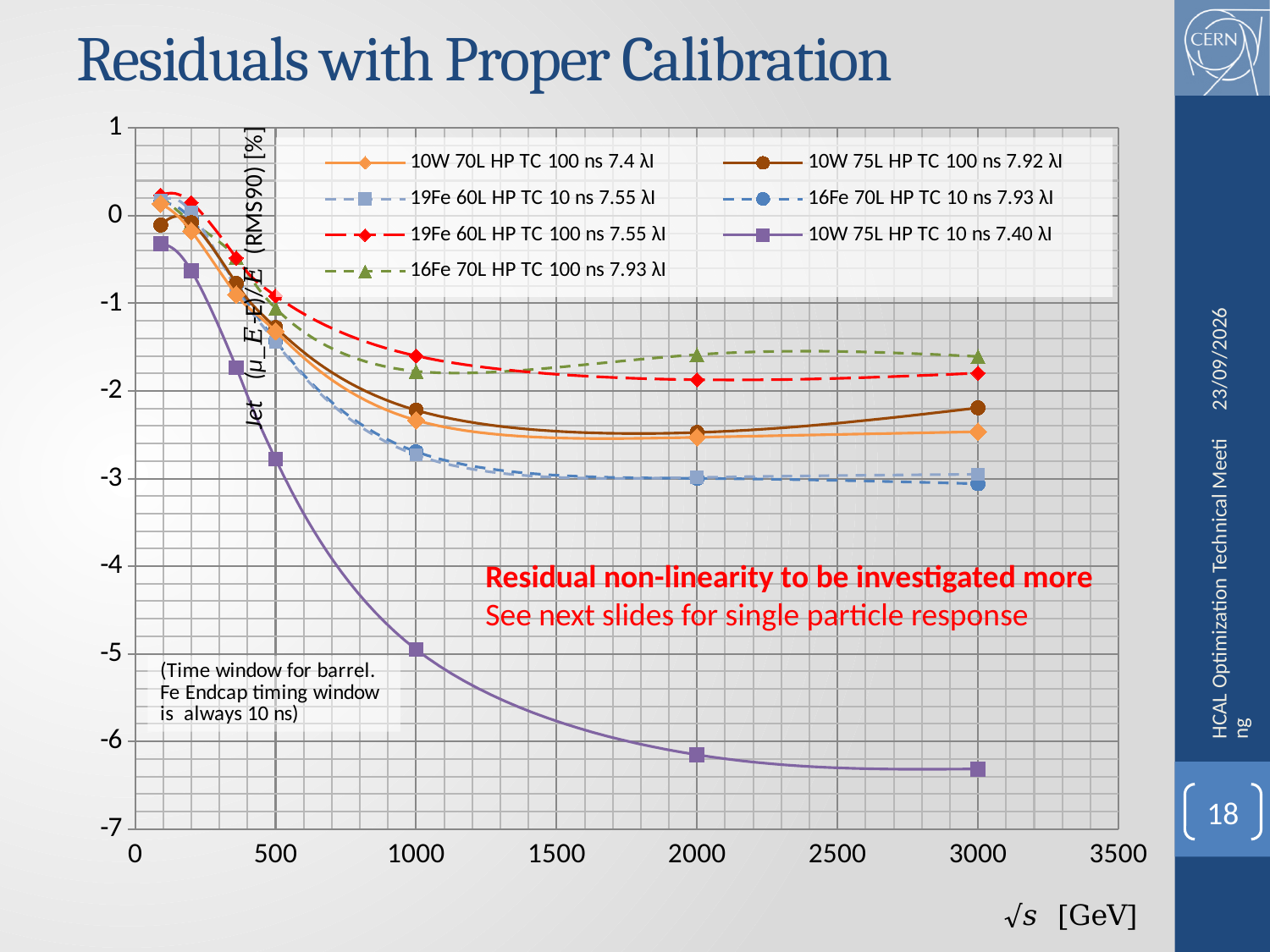
At 2000 GeV, which is larger: the value for 10W 75L HP TC 100 ns 7.92 λI or for 16Fe 70L HP TC 10 ns 7.93 λI? 10W 75L HP TC 100 ns 7.92 λI What is the label of the x axis? √s [GeV] How many series does the legend list? 7 Is the value for 10W 75L HP TC 10 ns 7.40 λI at 3000 GeV greater or less than -6? less Is the value for 10W 75L HP TC 10 ns 7.40 λI at 1000 GeV greater or less than -4? less Which series has the lowest value at 1000 GeV? 10W 75L HP TC 10 ns 7.40 λI Which series has the highest value at 2000 GeV? 16Fe 70L HP TC 100 ns 7.93 λI What kind of chart is shown on the slide? line chart Which series has the lowest value at 3000 GeV? 10W 75L HP TC 10 ns 7.40 λI What is the title of the chart? Residuals with Proper Calibration Is the value for 19Fe 60L HP TC 100 ns 7.55 λI at 3000 GeV greater or less than -2? greater Does the 10W 75L HP TC 10 ns 7.40 λI series rise or fall as √s increases from 500 to 3000 GeV? fall